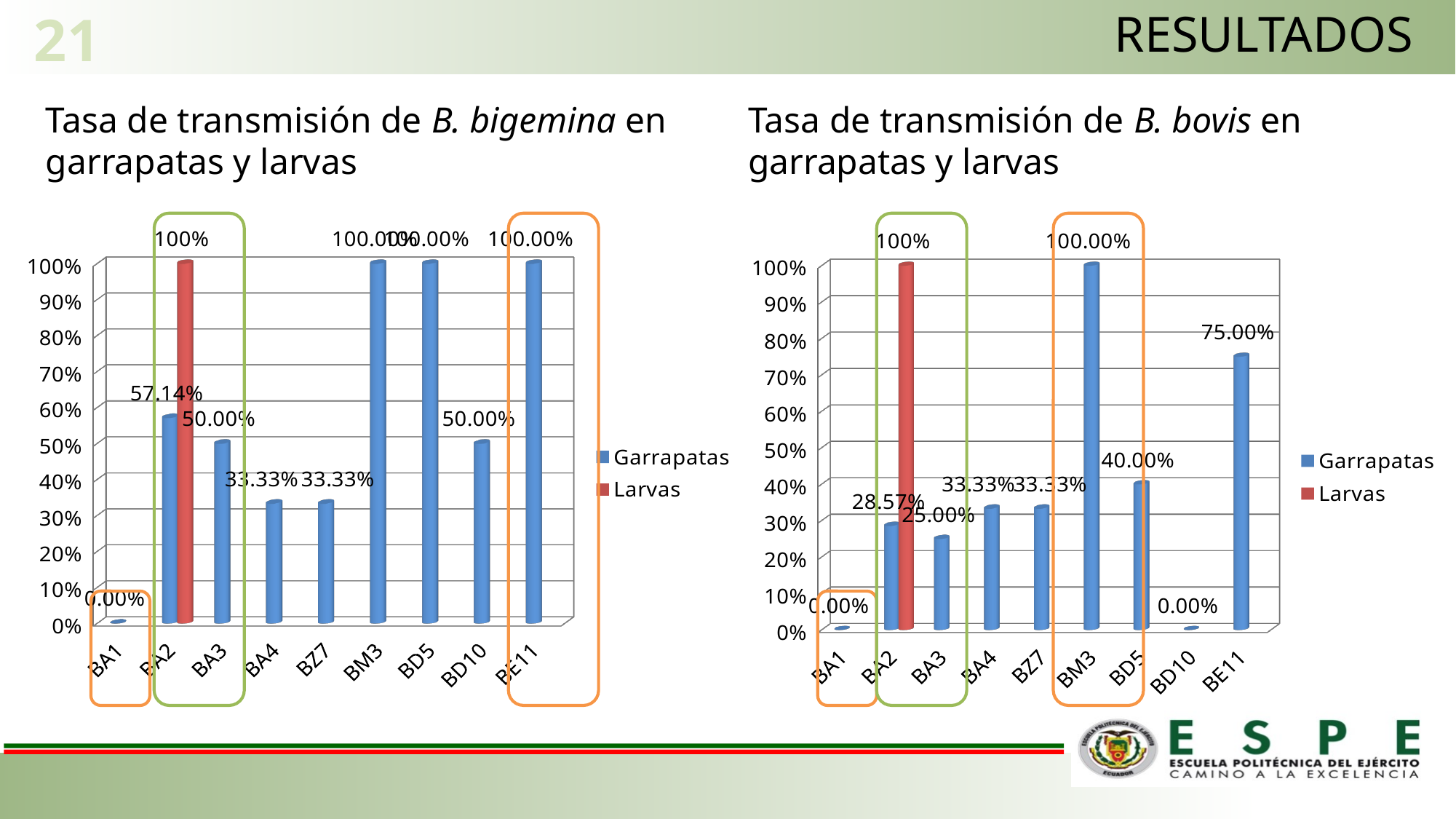
In the B. bovis chart on the right, what is the difference between the Garrapatas values for BE11 and BD5? 35.00% In the B. bovis chart on the right, what is the Garrapatas value for BD5? 40.00% In the B. bovis chart on the right, which category has the lowest Garrapatas value other than BA1? BD10 In the B. bigemina chart on the left, what is the Larvas value for BA2? 100% In the B. bigemina chart on the left, what is the Garrapatas value for BA2? 57.14% In the B. bovis chart on the right, which colour represents the Larvas series? Red In the B. bovis chart on the right, what is the Garrapatas value for BE11? 75.00% How many series does the legend of the B. bovis chart on the right list? 2 In the B. bigemina chart on the left, what is the difference between the Garrapatas values for BA2 and BA3? 7.14% In the B. bovis chart on the right, which is larger, the Garrapatas value for BA2 or for BA3? BA2 What kind of chart is the B. bigemina chart on the left? Bar chart How many categories are shown on the x axis of the B. bigemina chart on the left? 9